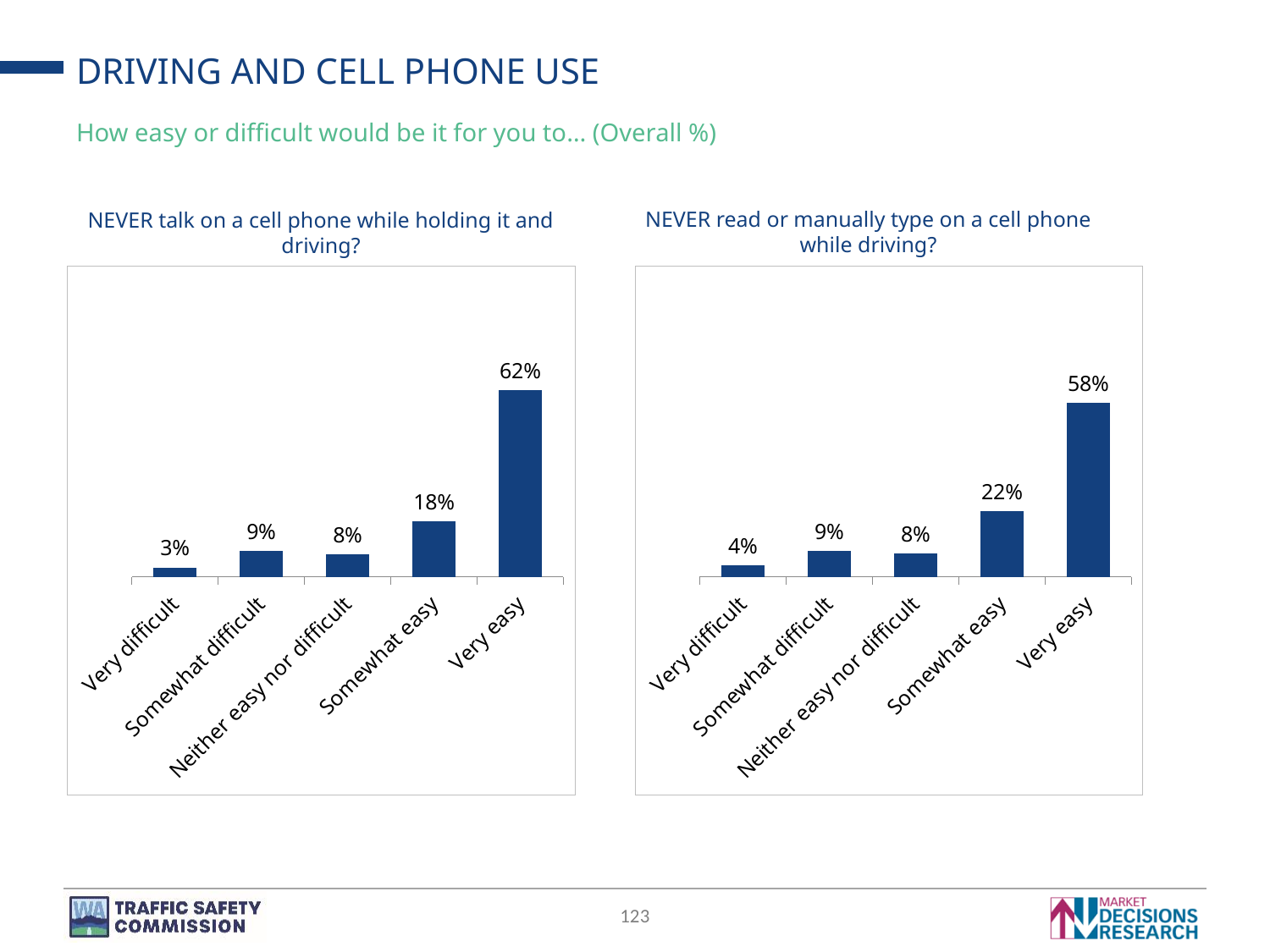
In the right chart (NEVER read or manually type on a cell phone while driving?), is the value for Very difficult larger or smaller than the value for Somewhat difficult? smaller In the left chart (NEVER talk on a cell phone while holding it and driving?), what is the difference between Very easy and Somewhat easy? 44% In the left chart (NEVER talk on a cell phone while holding it and driving?), what is the value for Very easy? 62% Which is larger: Very easy in the left chart or Very easy in the right chart? Very easy in the left chart In the left chart (NEVER talk on a cell phone while holding it and driving?), what is the value for Neither easy nor difficult? 8% In the left chart (NEVER talk on a cell phone while holding it and driving?), which category has the lowest value? Very difficult In the right chart (NEVER read or manually type on a cell phone while driving?), what is the difference between Somewhat easy and Somewhat difficult? 13% What type of chart is the right chart (NEVER read or manually type on a cell phone while driving?)? bar chart What is the title of the right chart? NEVER read or manually type on a cell phone while driving? In the right chart (NEVER read or manually type on a cell phone while driving?), what is the value for Somewhat easy? 22% In the right chart (NEVER read or manually type on a cell phone while driving?), which category has the highest value? Very easy How many categories are shown in the left chart (NEVER talk on a cell phone while holding it and driving?)? 5